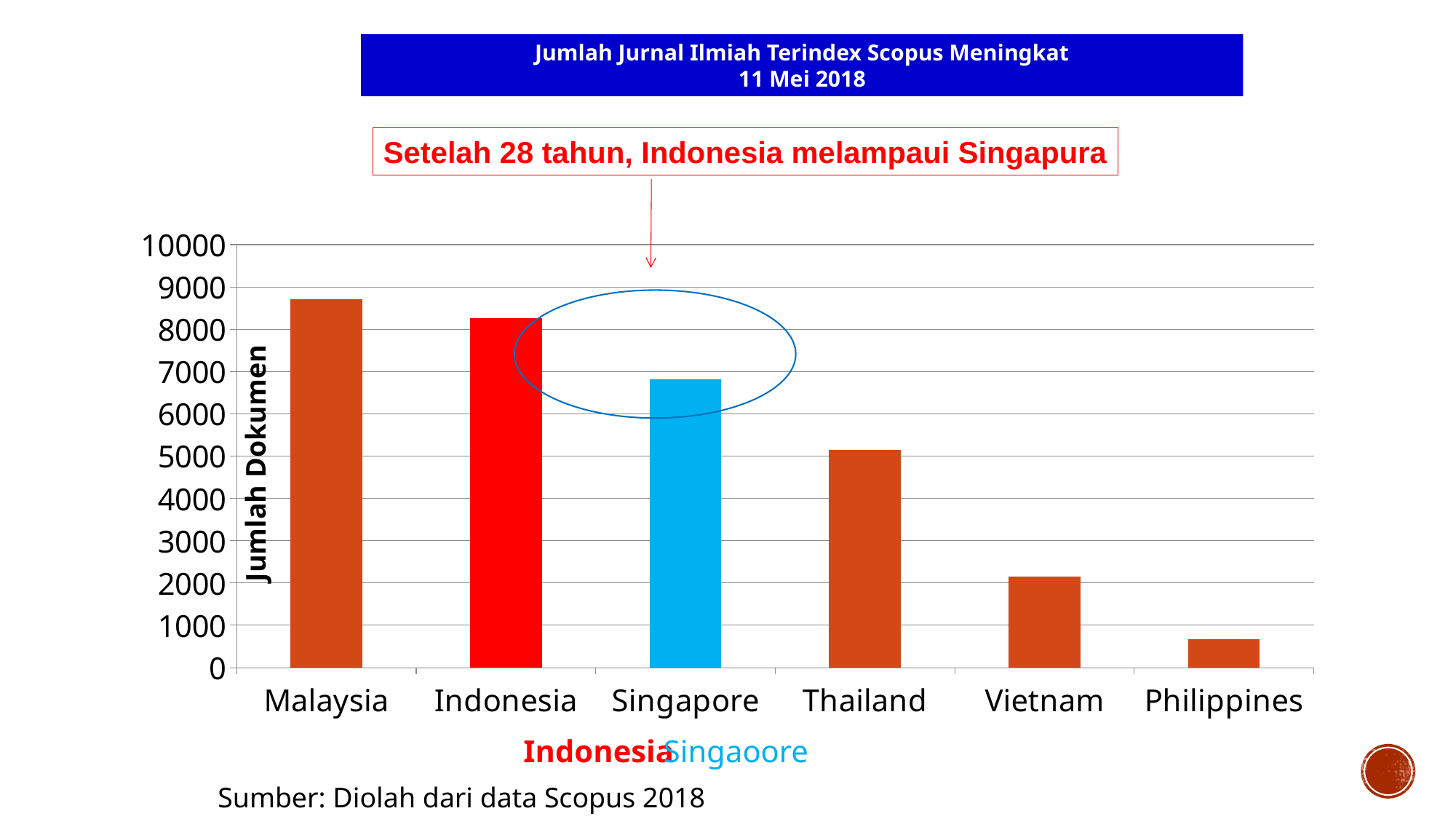
Which has a larger value in the chart, Indonesia or Singapore? Indonesia Which country has the lowest number of documents in the chart? Philippines How many countries are shown on the x axis of the chart? 6 Is the value for Singapore greater or less than 7000? less What is the label on the vertical axis of the chart? Jumlah Dokumen Is the value for Thailand greater or less than 5000? greater Is the value for Philippines greater or less than 1000? less Do the bar values rise or fall from Malaysia to Philippines along the x axis? fall Which country has the highest number of documents in the chart? Malaysia Which has a larger value in the chart, Thailand or Vietnam? Thailand What kind of chart is shown on the slide? bar chart